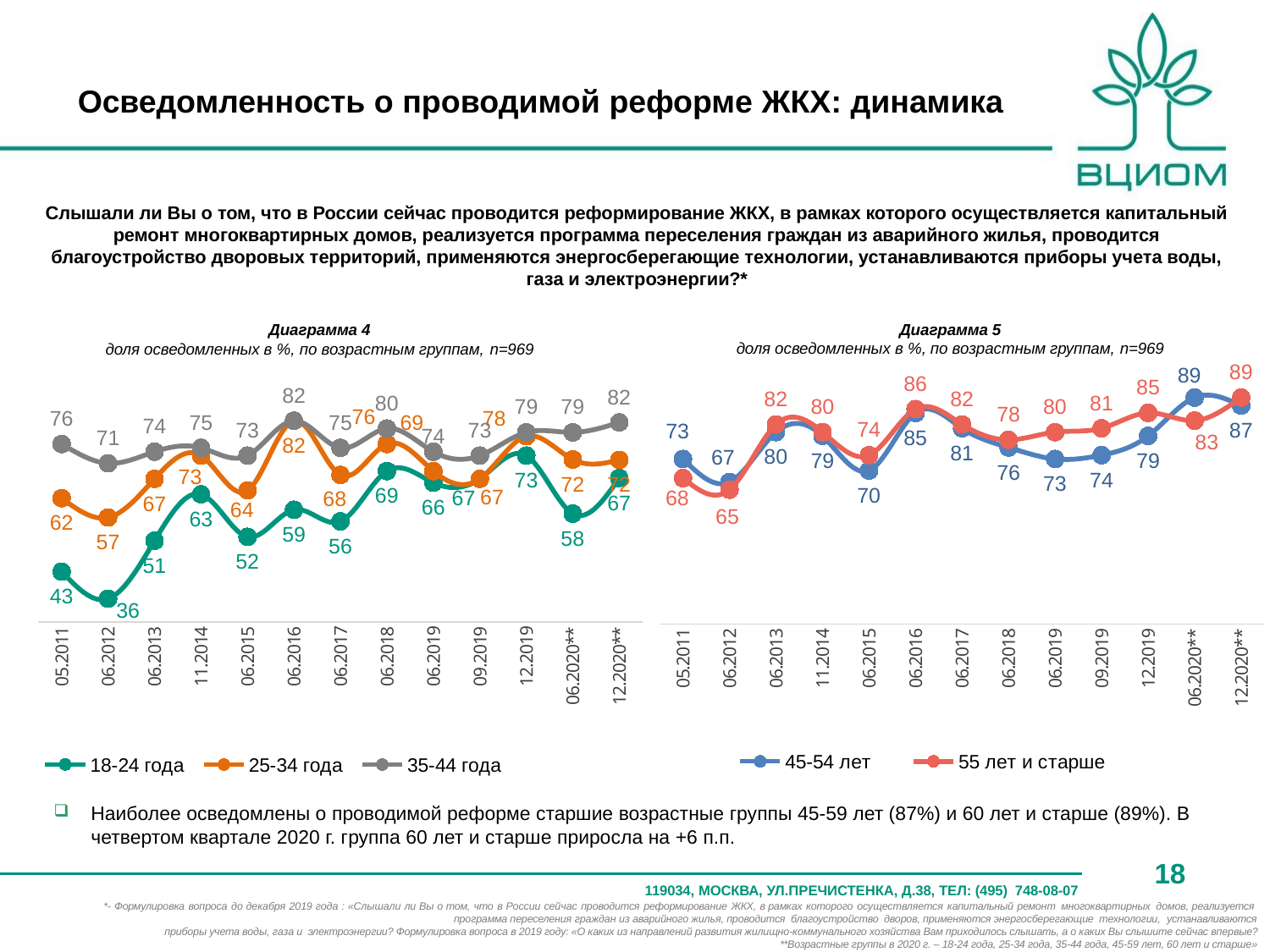
On Диаграмма 4, what is the value for the 18-24 года series at 05.2011? 43 On Диаграмма 4, what is the difference between the 35-44 года and 18-24 года values at 06.2012? 35 On Диаграмма 4, how many dates are shown on the x axis? 13 On Диаграмма 4, what is the value for the 35-44 года series at 12.2020**? 82 On Диаграмма 4, how many series does the legend list? 3 On Диаграмма 5, does the 45-54 лет series rise or fall from 05.2011 to 06.2012? Fall On Диаграмма 5, what is the value for the 55 лет и старше series at 12.2020**? 89 What type of chart is Диаграмма 5? Line chart On Диаграмма 4, at which date does the 18-24 года series reach its lowest value? 06.2012 On Диаграмма 5, what is the difference between the 55 лет и старше and 45-54 лет values at 09.2019? 7 On Диаграмма 5, which series has the larger value at 06.2020**: 45-54 лет or 55 лет и старше? 45-54 лет On Диаграмма 5, at which date does the 45-54 лет series reach its highest value? 06.2020**